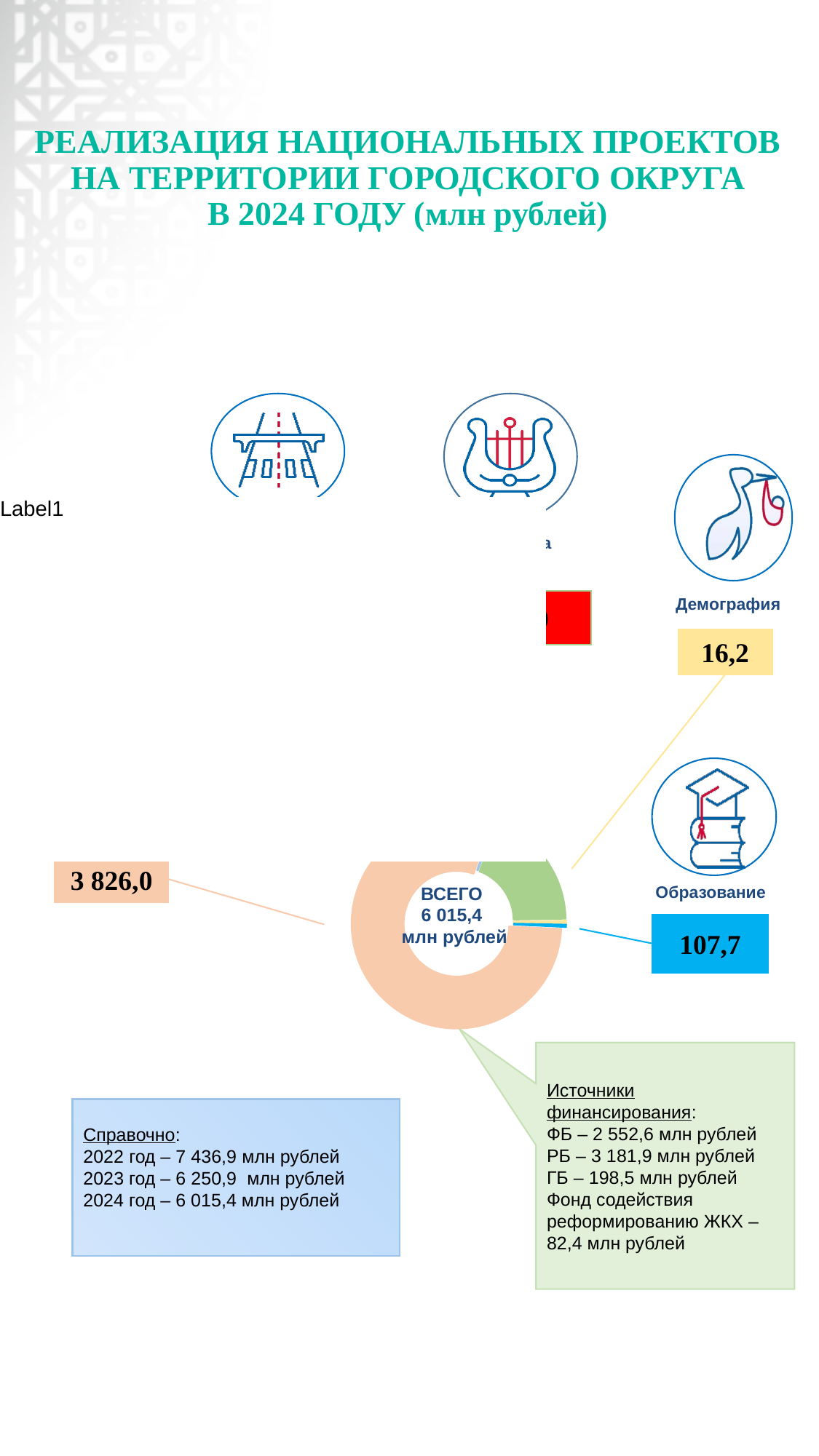
What is the value printed on the label attached to the largest (orange) slice of the donut? 3 826,0 What colour is the slice representing Образование (107,7)? Blue Which slice of the donut chart is the largest: the orange slice labelled 3 826,0, the green slice, or the blue slice labelled 107,7? The orange slice labelled 3 826,0 What total is printed in the centre of the donut chart? 6 015,4 млн рублей What value is shown for Демография on the chart? 16,2 Which of the two labelled categories, Демография or Образование, has the smallest value? Демография Which is larger, the value for Демография or the value for Образование? Образование What unit is stated in the slide title for the values on the chart? млн рублей What is the difference between the values for Образование and Демография? 91,5 What kind of chart is shown on the slide? Donut (pie) chart What value is shown for Образование on the chart? 107,7